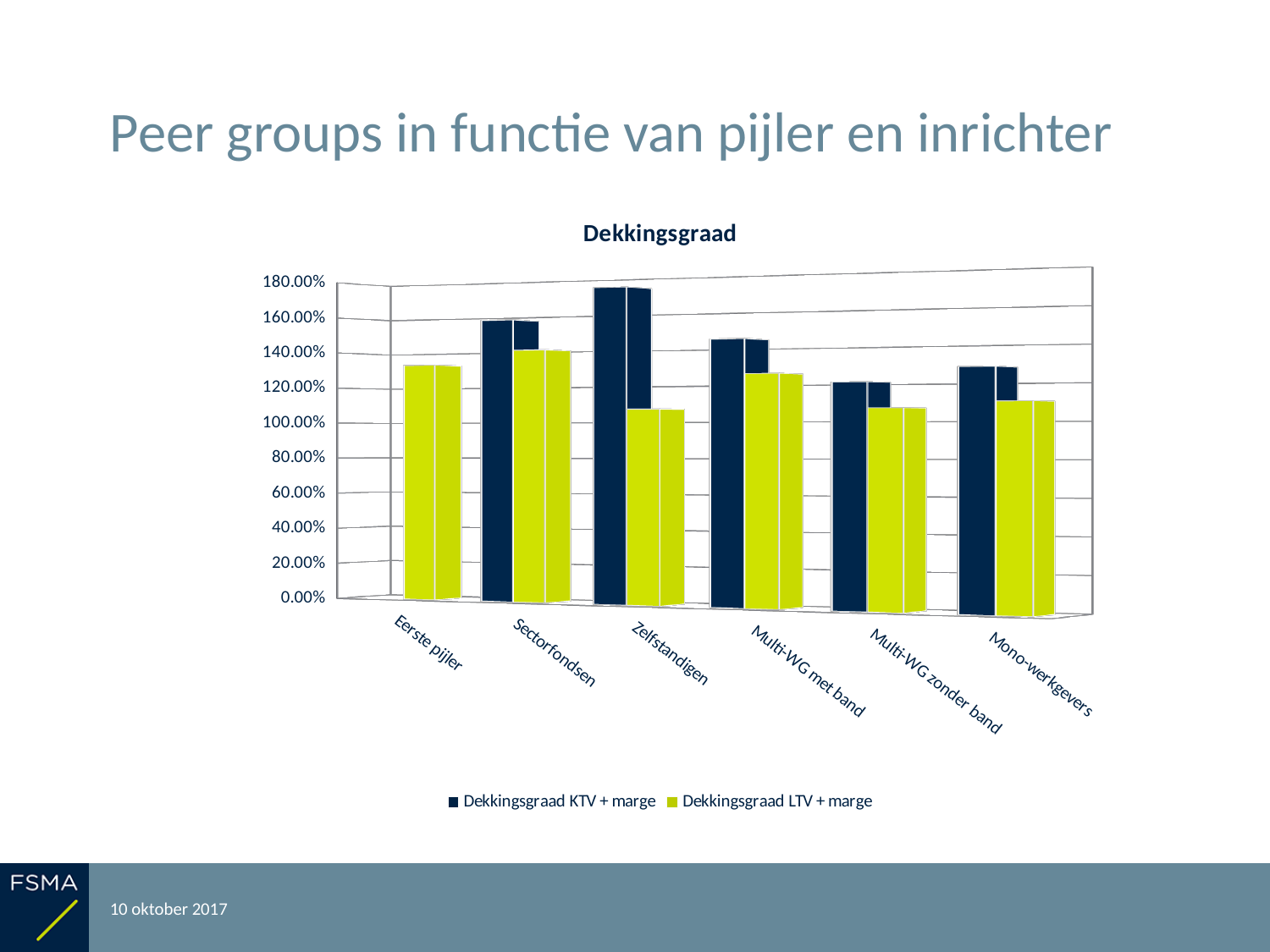
Which category has the highest value for Dekkingsgraad KTV + marge? Zelfstandigen What is the title of the chart? Dekkingsgraad Is the Dekkingsgraad KTV + marge value for Sectorfondsen greater or less than 140.00%? greater How many categories are shown on the x axis? 6 Is the Dekkingsgraad KTV + marge value for Zelfstandigen greater or less than 160.00%? greater Is the Dekkingsgraad LTV + marge value for Eerste pijler greater or less than 120.00%? greater How many series does the legend list? 2 Which category has the highest value for Dekkingsgraad LTV + marge? Sectorfondsen For Zelfstandigen, which is larger: Dekkingsgraad KTV + marge or Dekkingsgraad LTV + marge? Dekkingsgraad KTV + marge What kind of chart is shown on the slide? bar chart Which series is shown in dark blue in the legend? Dekkingsgraad KTV + marge